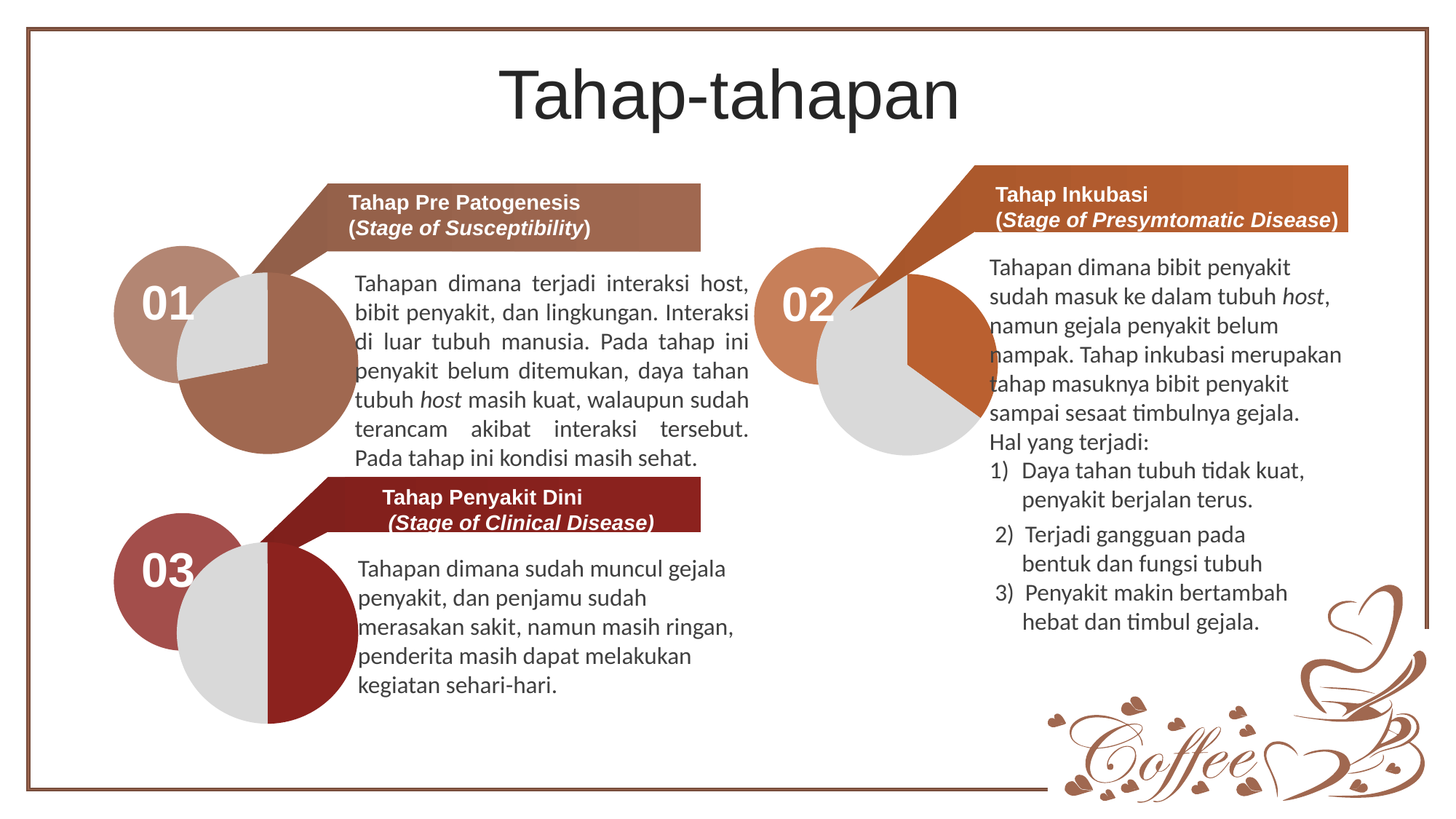
In the pie chart next to 02, which slice is larger, the orange slice or the grey slice? the grey slice In the pie chart next to 01, which slice is larger, the brown slice or the grey slice? the brown slice In the pie chart next to 01, how many slices are there? 2 What kind of chart is shown next to the number 02? pie chart Which stage heading is placed above the pie chart next to 03? Tahap Penyakit Dini (Stage of Clinical Disease) In the pie chart next to 03, how many slices are there? 2 In the pie chart next to 02, how many slices are there? 2 What kind of chart is shown next to the number 03? pie chart What kind of chart is shown next to the number 01? pie chart Which stage heading is placed above the pie chart next to 02? Tahap Inkubasi (Stage of Presymtomatic Disease)